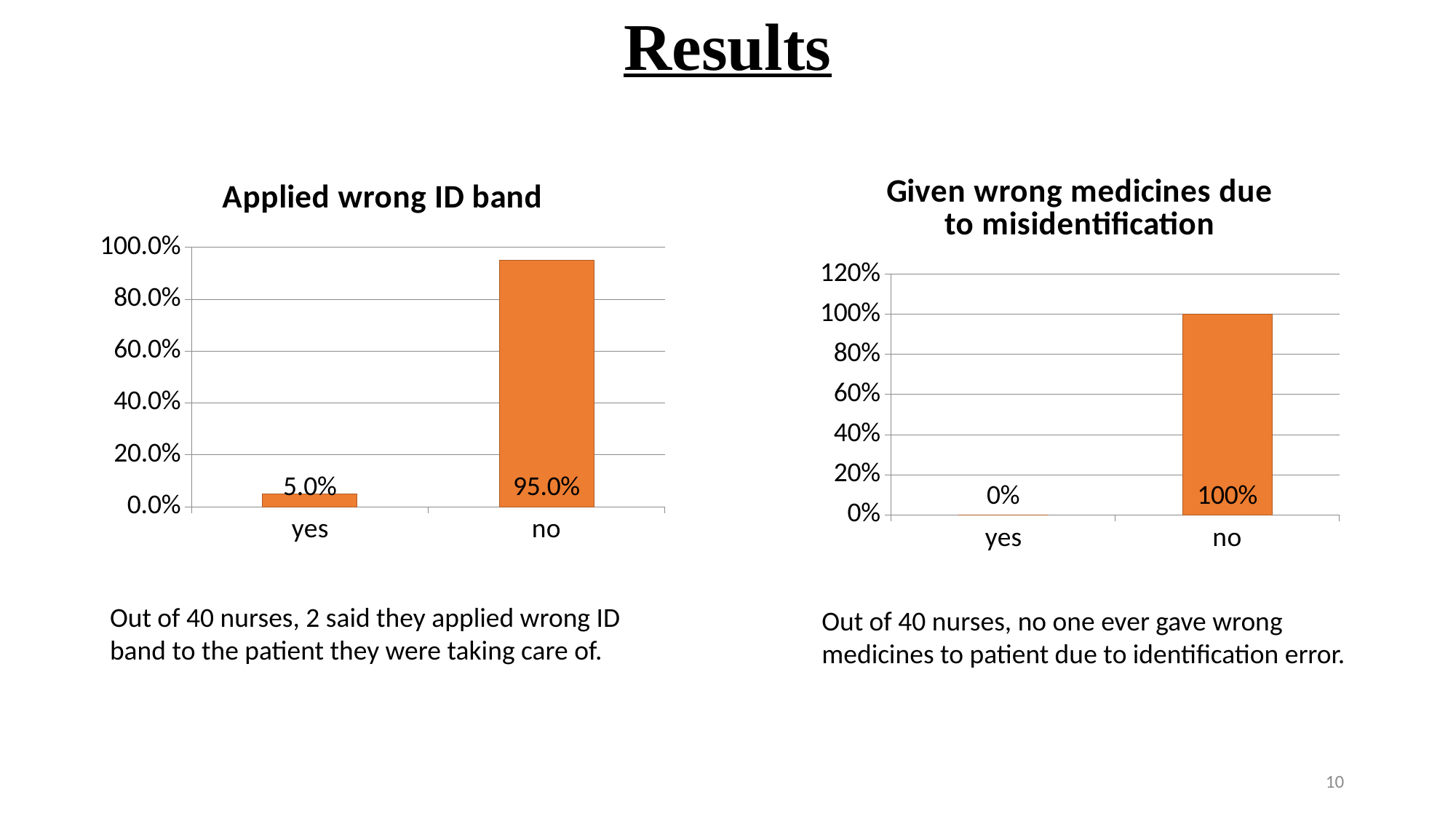
In the 'Applied wrong ID band' chart, which category has the highest value? no In the 'Given wrong medicines due to misidentification' chart, what is the value for 'no'? 100% In the 'Given wrong medicines due to misidentification' chart, is the value for 'no' larger or smaller than the value for 'yes'? larger In the 'Given wrong medicines due to misidentification' chart, what is the value for 'yes'? 0% In the 'Applied wrong ID band' chart, is the value for 'no' greater or less than 80.0%? greater In the 'Applied wrong ID band' chart, what is the value for 'yes'? 5.0% In the 'Given wrong medicines due to misidentification' chart, which category has the lowest value? yes What kind of chart is the 'Given wrong medicines due to misidentification' chart? bar chart In the 'Applied wrong ID band' chart, what is the difference between the values for 'no' and 'yes'? 90.0% In the 'Applied wrong ID band' chart, what is the value for 'no'? 95.0% What is the title of the chart on the left side of the slide? Applied wrong ID band How many categories are shown in the 'Applied wrong ID band' chart? 2